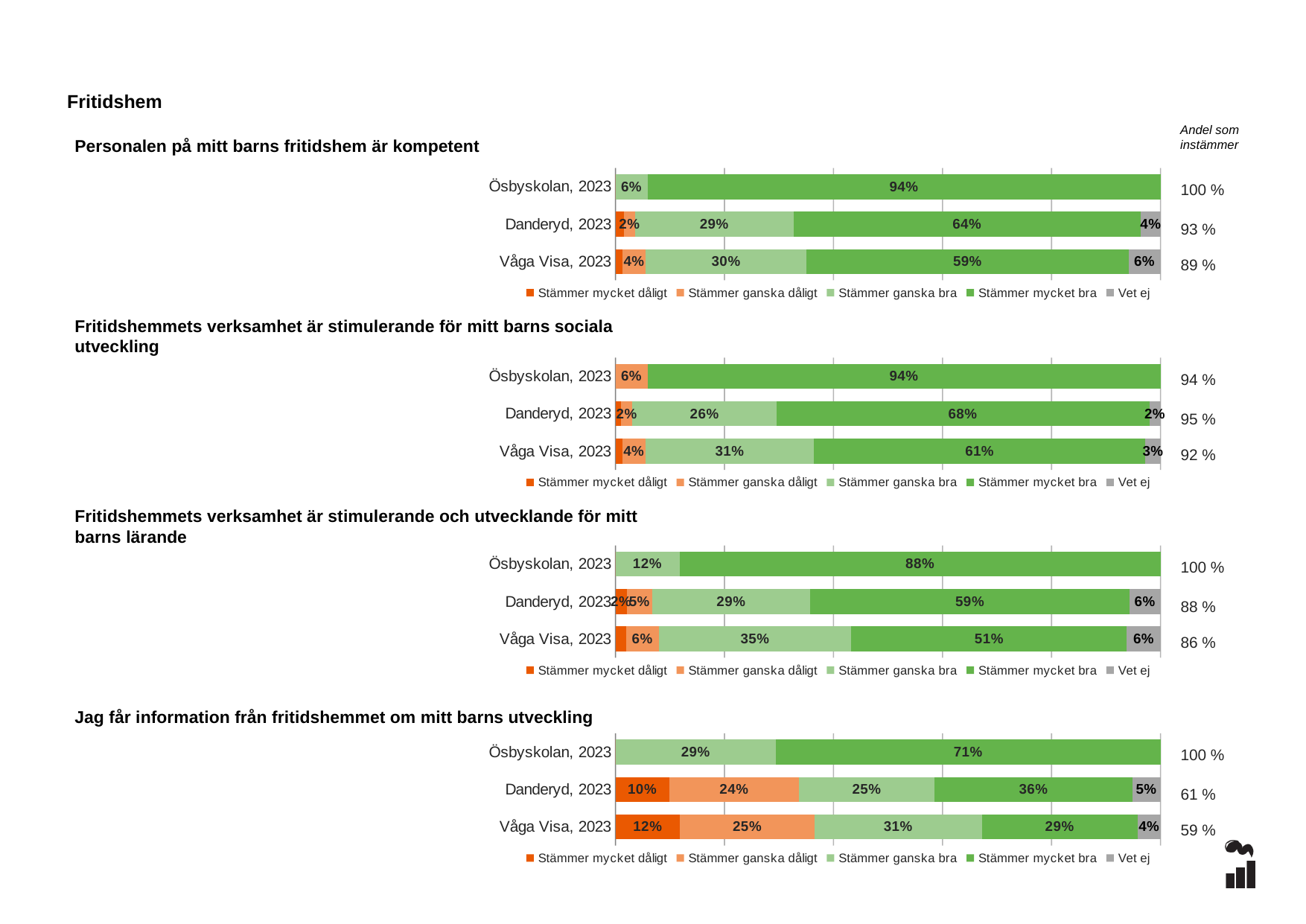
In the chart 'Personalen på mitt barns fritidshem är kompetent', what is the 'Stämmer ganska bra' value for Våga Visa, 2023? 30% In the chart 'Fritidshemmets verksamhet är stimulerande för mitt barns sociala utveckling', what is the difference between the 'Stämmer mycket bra' values for Danderyd, 2023 and Våga Visa, 2023? 7% In the chart 'Personalen på mitt barns fritidshem är kompetent', what is the 'Stämmer mycket bra' value for Ösbyskolan, 2023? 94% In the chart 'Fritidshemmets verksamhet är stimulerande och utvecklande för mitt barns lärande', which has the larger 'Stämmer mycket bra' value, Danderyd, 2023 or Våga Visa, 2023? Danderyd, 2023 In the chart 'Personalen på mitt barns fritidshem är kompetent', which category has the highest 'Stämmer mycket bra' value? Ösbyskolan, 2023 In the chart 'Fritidshemmets verksamhet är stimulerande för mitt barns sociala utveckling', what is the 'Stämmer mycket bra' value for Danderyd, 2023? 68% In the chart 'Fritidshemmets verksamhet är stimulerande och utvecklande för mitt barns lärande', what is the 'Stämmer ganska bra' value for Ösbyskolan, 2023? 12% How many series does the legend list in the chart 'Jag får information från fritidshemmet om mitt barns utveckling'? 5 How many categories are shown in the chart 'Personalen på mitt barns fritidshem är kompetent'? 3 What kind of chart is 'Jag får information från fritidshemmet om mitt barns utveckling'? Stacked bar chart In the chart 'Jag får information från fritidshemmet om mitt barns utveckling', which category has the lowest 'Stämmer mycket bra' value? Våga Visa, 2023 In the chart 'Jag får information från fritidshemmet om mitt barns utveckling', what is the 'Stämmer mycket dåligt' value for Våga Visa, 2023? 12%